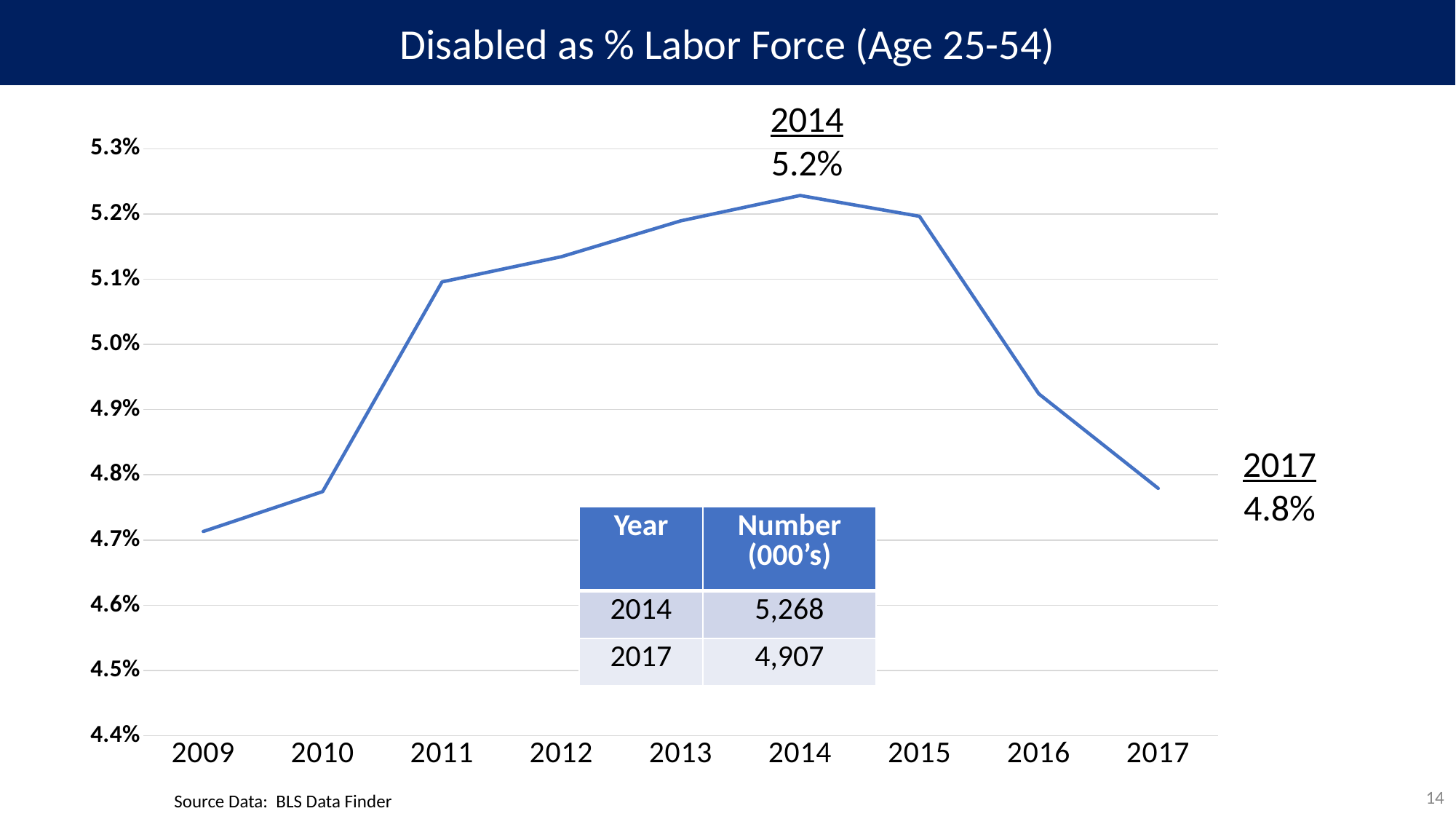
Which year has the lowest value? 2009 What is the value for 2014? 5.2% What is the difference between the 2014 value and the 2017 value? 0.4 percentage points How many years are plotted along the x axis? 9 Is the value for 2009 greater or less than 4.8%? less What is the title of the chart? Disabled as % Labor Force (Age 25-54) Do the values rise or fall from 2014 to 2017? fall What is the value for 2017? 4.8% Is the value for 2016 greater or less than 5.0%? less What kind of chart is shown on the slide? line chart Which year has the highest value? 2014 Which year has the larger value, 2011 or 2016? 2011